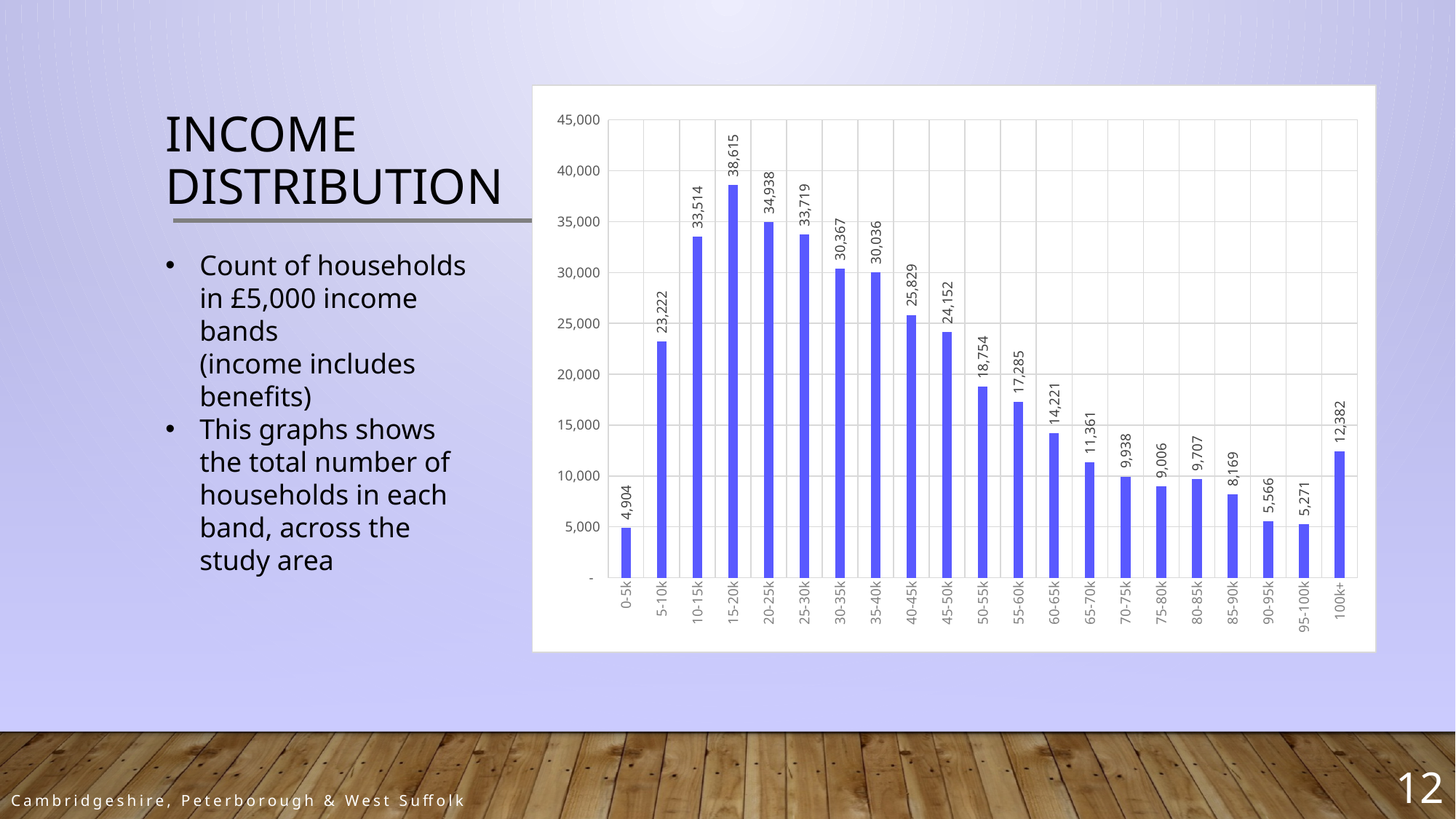
Which income band has the lowest number of households? 0-5k Which income band has the highest number of households? 15-20k What is the value shown for the 45-50k band? 24,152 What is the count of households in the 15-20k income band? 38,615 Is the value for the 5-10k band greater or less than 20,000? greater Which has more households, the 75-80k band or the 80-85k band? 80-85k What is the difference between the 100k+ band and the 95-100k band? 7,111 What is the difference between the 15-20k band and the 0-5k band? 33,711 What kind of chart is shown on the slide? Bar chart Do the values rise or fall from the 15-20k band to the 95-100k band? Fall What is the count of households in the 100k+ income band? 12,382 How many income bands are shown on the x axis? 21